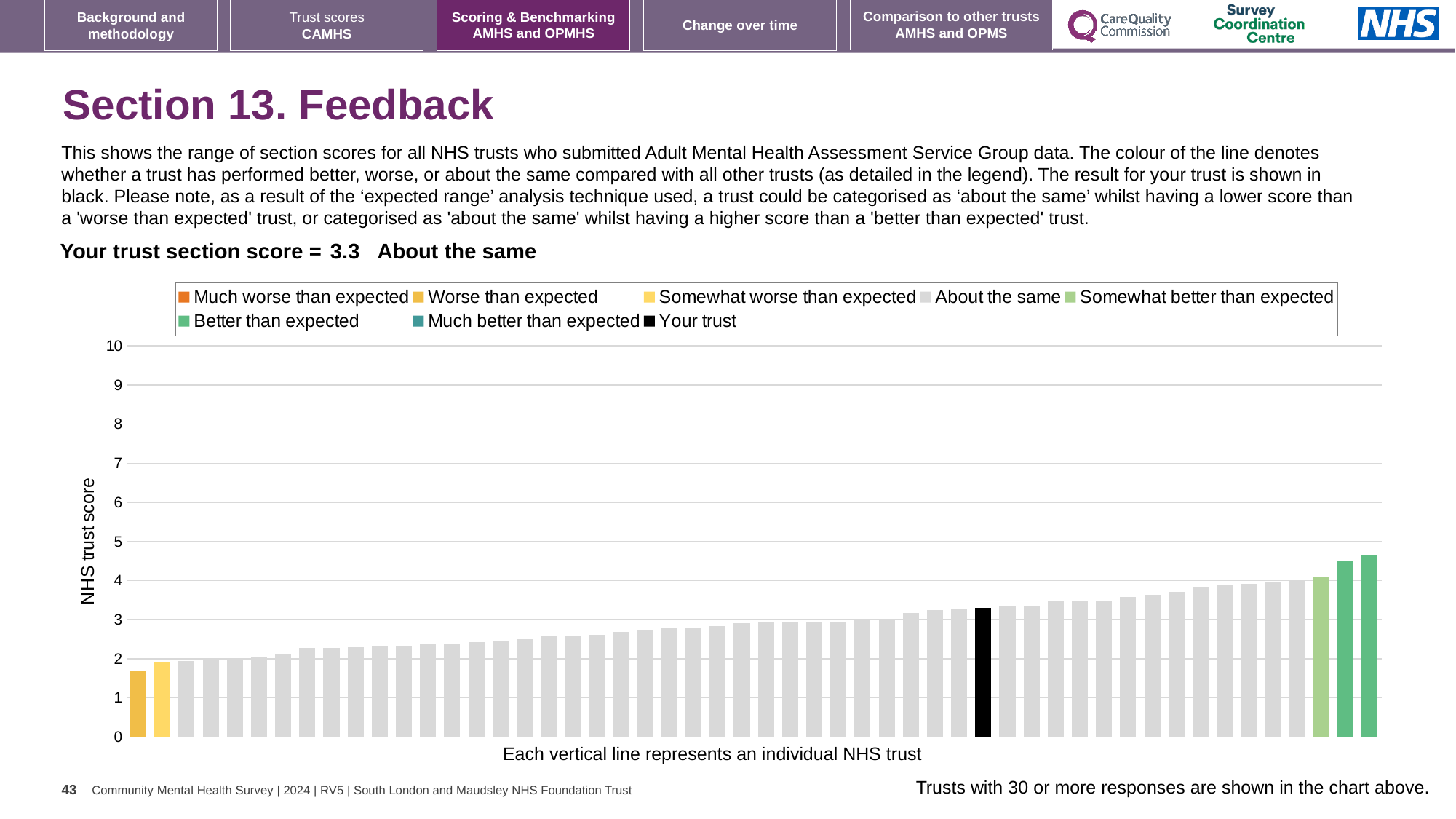
Do the bar values rise or fall from left to right across the chart? rise Which category is your trust placed in, according to the slide? About the same Is the value of the shortest bar in the chart greater or less than 2? less Which is larger, the leftmost bar or the rightmost bar? the rightmost bar How many entries does the chart legend list? 8 Is the value of the black 'Your trust' bar greater or less than 3? greater What is the section score for your trust, as stated on the slide? 3.3 Is the value of the tallest bar in the chart greater or less than 4? greater What is the label on the vertical axis of the chart? NHS trust score What kind of chart is shown on the slide? bar chart